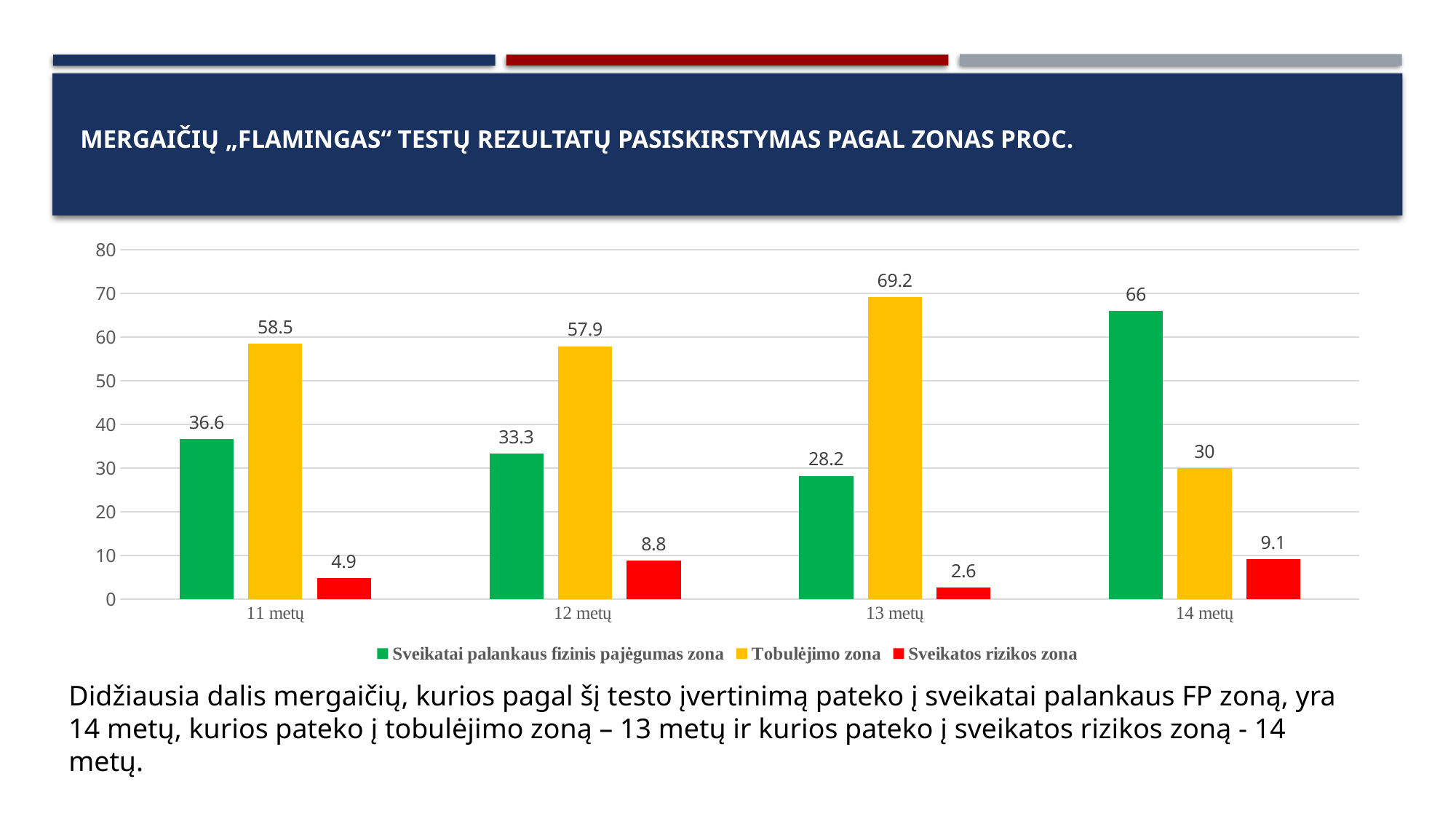
What is the value for "Tobulėjimo zona" at 13 metų? 69.2 How many age groups are shown on the x axis? 4 What is the value for "Sveikatos rizikos zona" at 12 metų? 8.8 Which is larger: "Sveikatai palankaus fizinis pajėgumas zona" at 11 metų or at 12 metų? 11 metų Do the values for "Sveikatai palankaus fizinis pajėgumas zona" rise or fall from 11 metų to 13 metų? Fall Which colour represents "Sveikatos rizikos zona" in the chart? Red How many series does the legend list? 3 Which age group has the lowest value for "Sveikatai palankaus fizinis pajėgumas zona"? 13 metų What is the value for "Sveikatai palankaus fizinis pajėgumas zona" at 14 metų? 66 What kind of chart is shown on the slide? Bar chart Which age group has the highest value for "Sveikatos rizikos zona"? 14 metų What is the difference between the "Tobulėjimo zona" values for 13 metų and 14 metų? 39.2